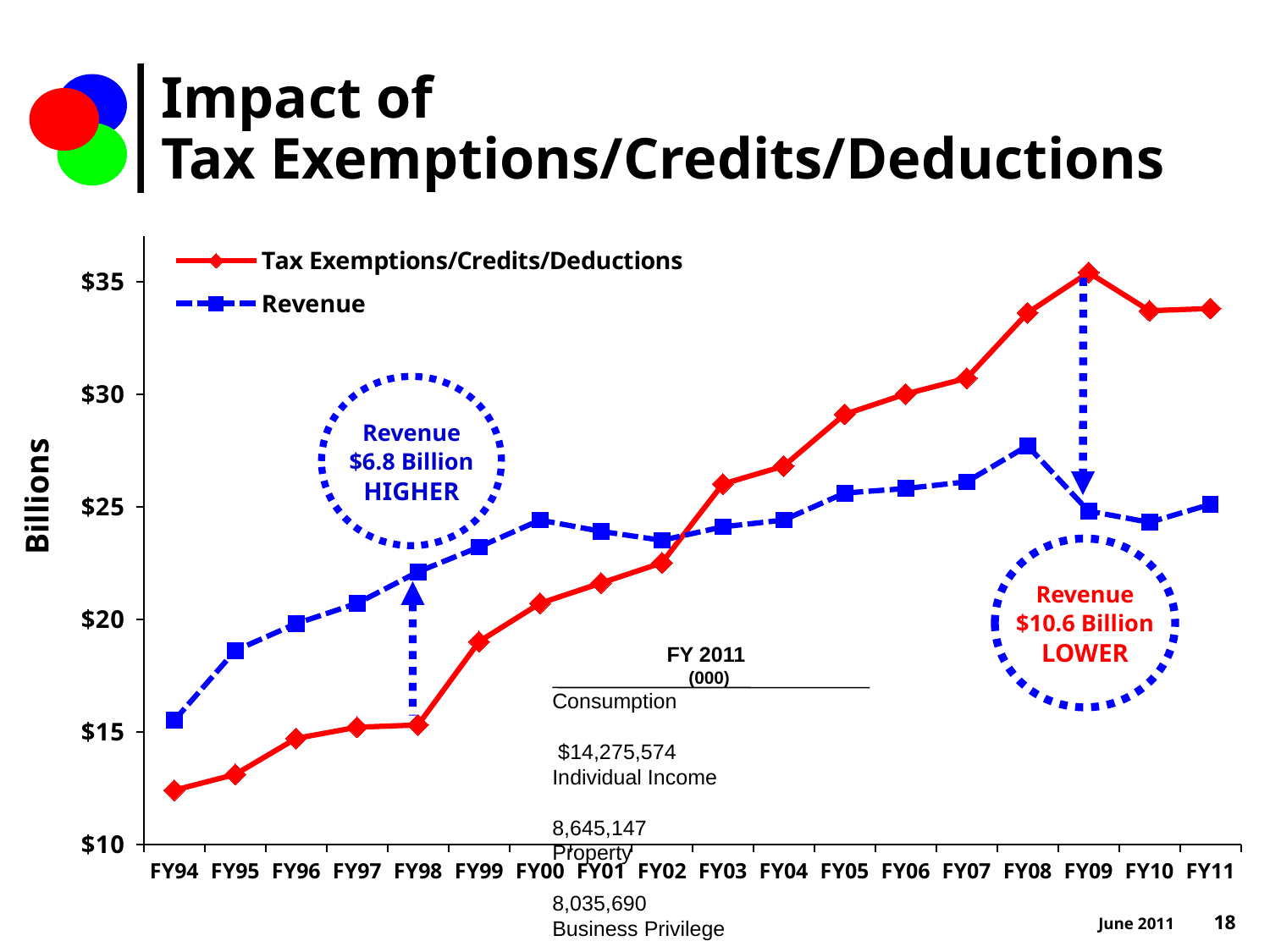
Which fiscal year has the highest Revenue value? FY08 Is the Tax Exemptions/Credits/Deductions value for FY11 greater or less than $30? greater Does the Tax Exemptions/Credits/Deductions line generally rise or fall from FY94 to FY11? Rise In FY94, which series is higher: Revenue or Tax Exemptions/Credits/Deductions? Revenue Which fiscal year has the lowest Revenue value? FY94 What kind of chart is shown on the slide? Line chart How many fiscal years are plotted along the x axis? 18 In FY11, which series is higher: Revenue or Tax Exemptions/Credits/Deductions? Tax Exemptions/Credits/Deductions Which fiscal year has the highest value for Tax Exemptions/Credits/Deductions? FY09 How many series does the legend list? 2 According to the annotation at FY09, by how much is Revenue lower? $10.6 Billion Is the Revenue value for FY94 greater or less than $20? less